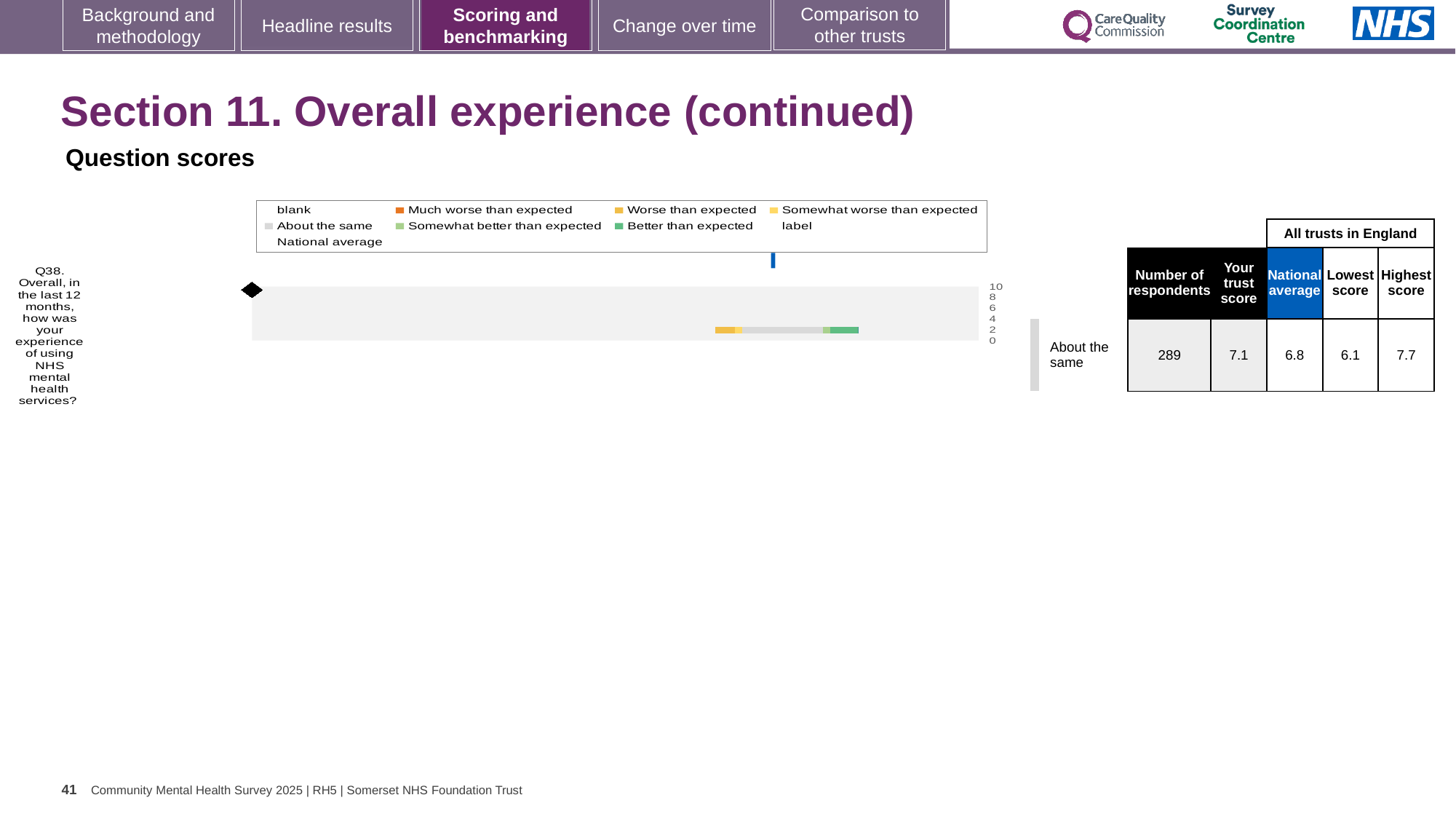
What kind of chart is used to show the Q38 question score? Bar chart What colour does the legend use for 'Better than expected'? Green What is the difference between the highest and lowest scores among all trusts in England for Q38? 1.6 How many respondents answered Q38 (Overall, in the last 12 months, how was your experience of using NHS mental health services?)? 289 For Q38, which is larger: the trust's score or the national average? The trust's score (7.1) What is the national average score for Q38? 6.8 What is the lowest score among all trusts in England for Q38? 6.1 What is the highest score among all trusts in England for Q38? 7.7 Which benchmark category is the trust's Q38 score placed in? About the same What is the trust's score for Q38? 7.1 How many survey questions are plotted on the chart? 1 By how much does the trust's score for Q38 exceed the national average? 0.3